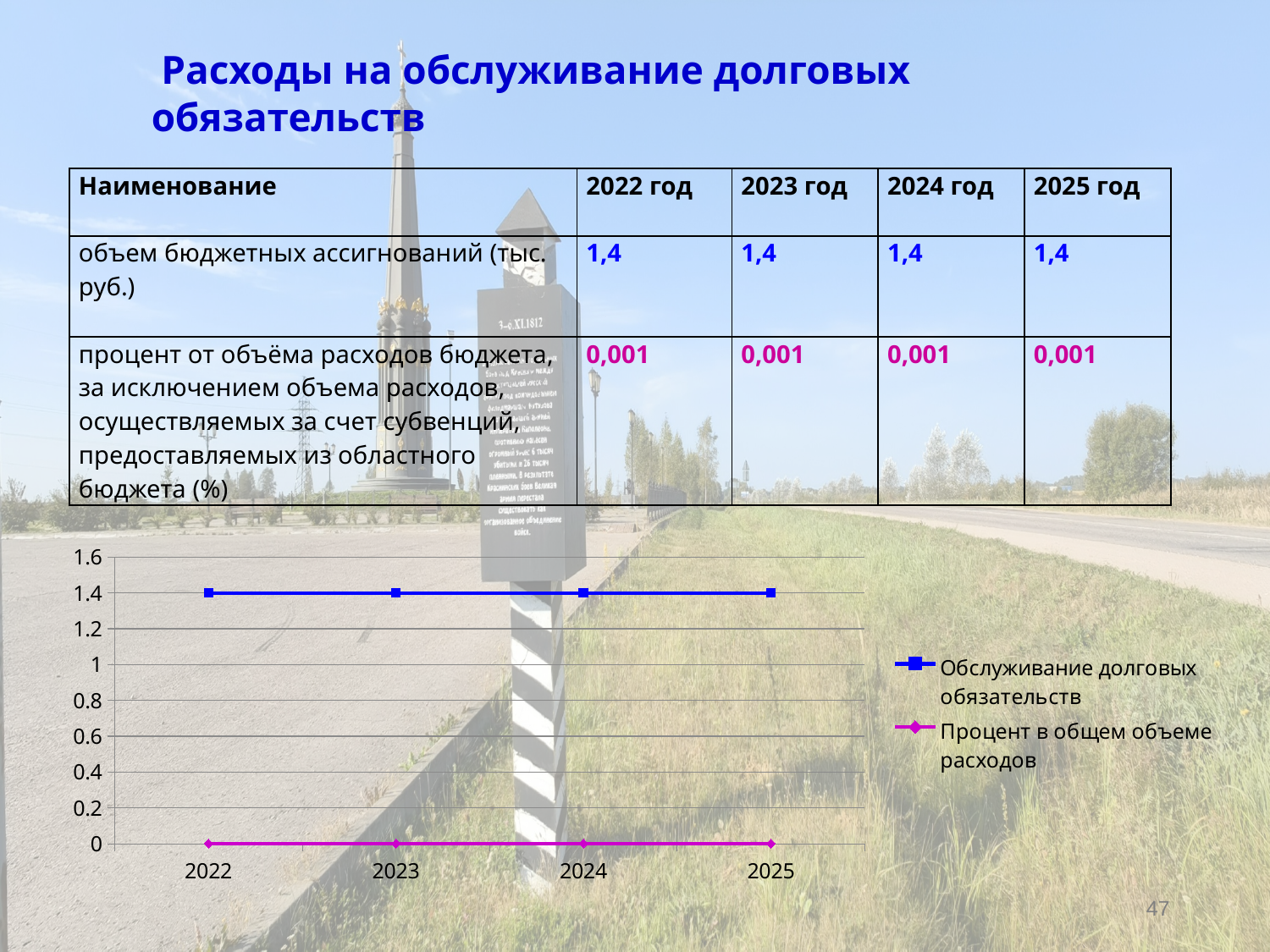
How many series does the chart legend list? 2 What value does the 'Обслуживание долговых обязательств' line show for 2025? 1.4 What colour is the 'Процент в общем объеме расходов' line in the chart? magenta Is the value of 'Процент в общем объеме расходов' for 2025 greater or less than 0.2? less What is the first year shown on the x axis of the chart? 2022 Which series has the higher value in 2024, 'Обслуживание долговых обязательств' or 'Процент в общем объеме расходов'? Обслуживание долговых обязательств Does the 'Обслуживание долговых обязательств' line rise, fall or stay flat from 2022 to 2025? stays flat Is the value of 'Обслуживание долговых обязательств' for 2023 greater or less than 1? greater What value does the 'Обслуживание долговых обязательств' line show for 2022? 1.4 What kind of chart is shown on the slide? line chart How many years are plotted along the x axis of the chart? 4